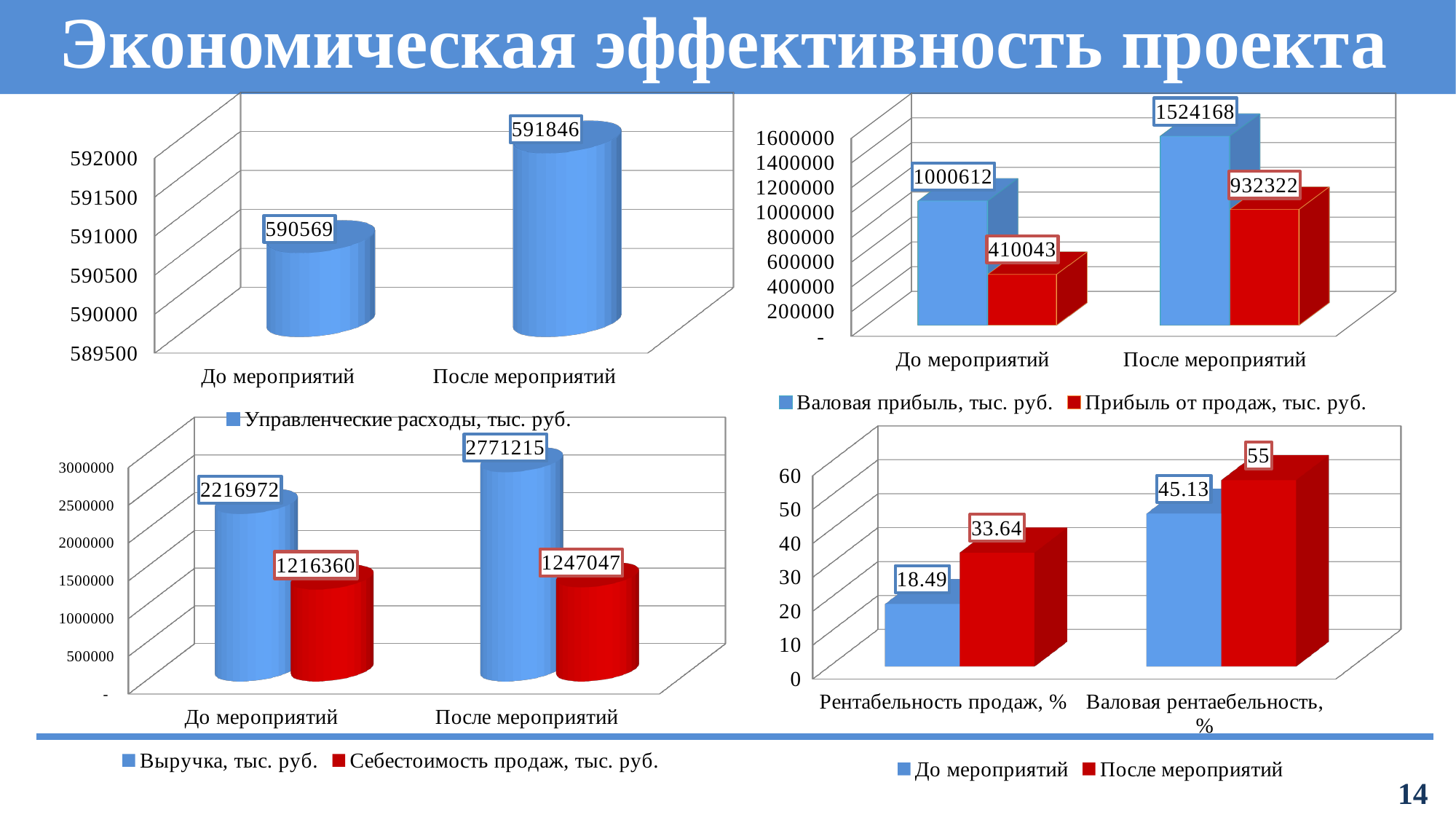
In the top-right chart, what is the value of Прибыль от продаж, тыс. руб. for До мероприятий? 410043 In the top-left chart, what is the value of Управленческие расходы for До мероприятий? 590569 In the top-right chart, how many series does the legend list? 2 In the bottom-right chart, what is the value of Валовая рентабельность, % for После мероприятий? 55 In the bottom-right chart, what is the difference between Рентабельность продаж, % for После мероприятий and До мероприятий? 15.15 In the bottom-left chart, which is larger: Выручка for До мероприятий or Себестоимость продаж for После мероприятий? Выручка for До мероприятий In the top-left chart, by how much does the value for После мероприятий exceed the value for До мероприятий? 1277 In the bottom-left chart, what is the value of Себестоимость продаж, тыс. руб. for До мероприятий? 1216360 In the top-right chart, what is the value of Валовая прибыль, тыс. руб. for После мероприятий? 1524168 In the bottom-left chart, what is the value of Выручка, тыс. руб. for После мероприятий? 2771215 In the top-left chart, what is the value of Управленческие расходы for После мероприятий? 591846 In the top-right chart, what is the difference between Прибыль от продаж for После мероприятий and До мероприятий? 522279